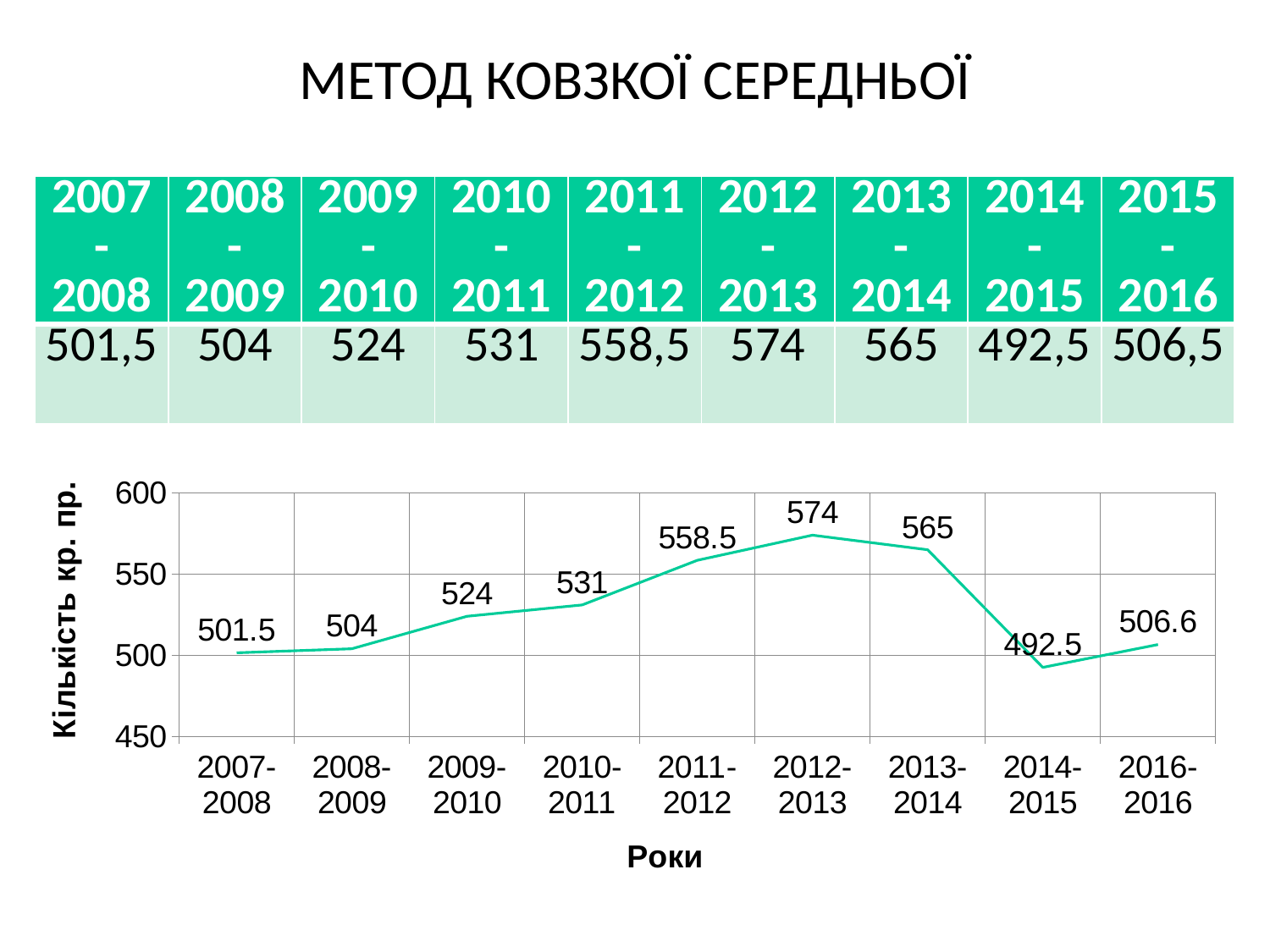
What is the value for 2012-2013 in the chart? 574 What is the label of the vertical axis of the chart? Кількість кр. пр. What is the value for 2011-2012 in the chart? 558.5 What is the difference between the values for 2009-2010 and 2008-2009? 20 Which period has the lowest value in the chart? 2014-2015 What is the value for 2014-2015 in the chart? 492.5 Which period has the highest value in the chart? 2012-2013 What is the difference between the values for 2012-2013 and 2014-2015? 81.5 Which is larger, the value for 2013-2014 or the value for 2010-2011? 2013-2014 How many data points are plotted in the chart? 9 What type of chart is shown on the slide? line chart Does the value rise or fall from 2013-2014 to 2014-2015? fall